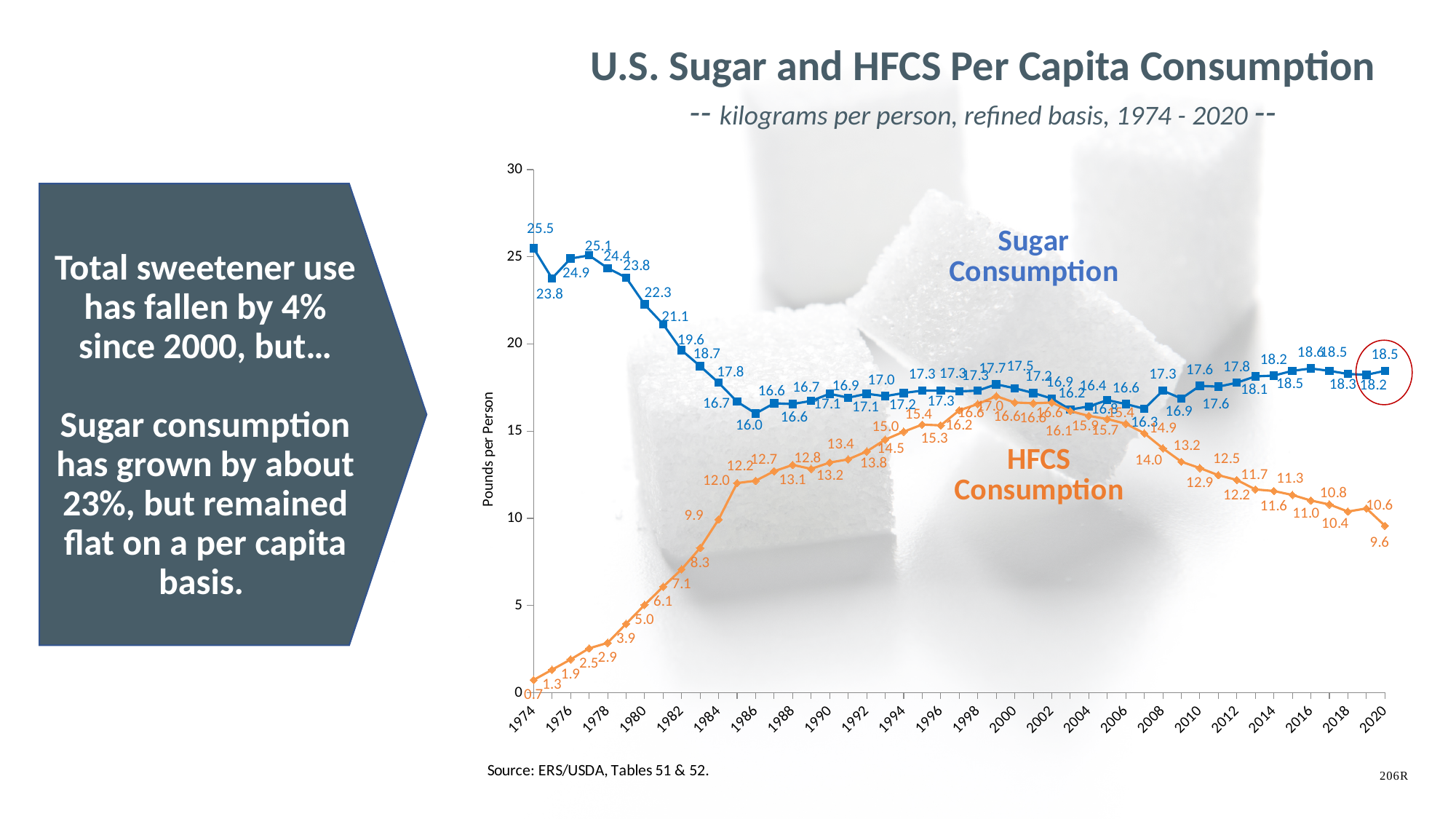
What was U.S. HFCS consumption per capita in 2020? 9.6 What type of chart is shown on the slide? line chart What is the difference between sugar consumption and HFCS consumption in 2020? 8.9 Did HFCS consumption rise or fall between 1974 and 1985? rise What was U.S. sugar consumption per capita in 1974? 25.5 In 1984, which was larger: sugar consumption or HFCS consumption? Sugar consumption How many series are plotted on the chart? 2 What is the circled sugar consumption value for 2020? 18.5 In which year was sugar consumption per capita highest? 1974 In which year was HFCS consumption per capita lowest? 1974 By how much did sugar consumption per capita fall from 1974 to 2020? 7.0 What is the label on the vertical axis of the chart? Pounds per Person